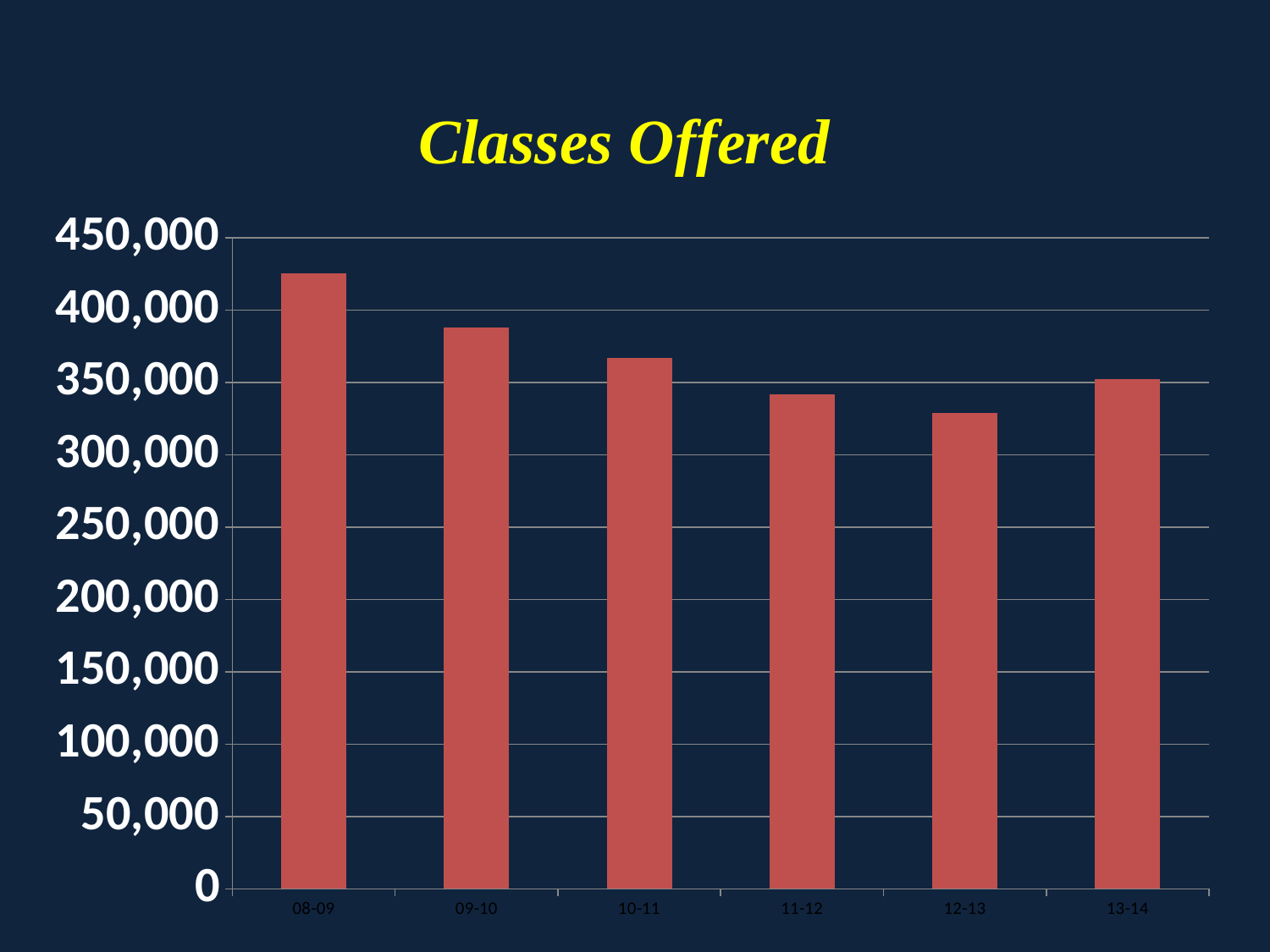
Which year has the lowest number of classes offered? 12-13 Is the value for 08-09 greater or less than 400,000? greater Is the value for 09-10 greater or less than 400,000? less Do the values rise or fall from 08-09 to 12-13? fall Which is larger, the value for 09-10 or the value for 10-11? 09-10 Which is larger, the value for 12-13 or the value for 13-14? 13-14 Which year has the highest number of classes offered? 08-09 What is the title of the chart? Classes Offered How many academic years are shown on the x axis? 6 Is the value for 10-11 greater or less than 350,000? greater What kind of chart is shown on the slide? bar chart